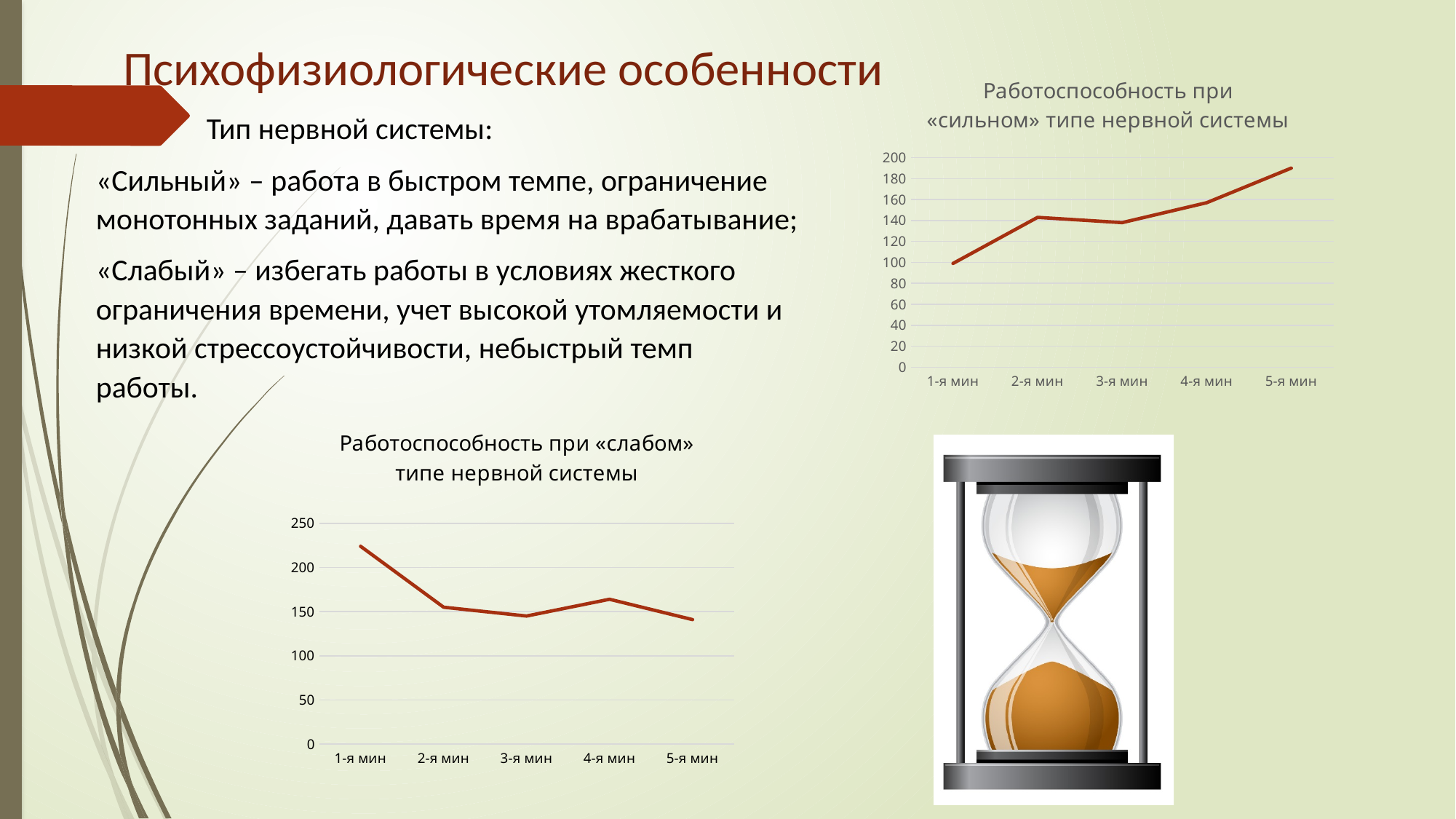
In the chart "Работоспособность при «слабом» типе нервной системы", which minute has the highest value? 1-я мин In the chart "Работоспособность при «слабом» типе нервной системы", is the value for 5-я мин greater or less than 150? less In the chart "Работоспособность при «сильном» типе нервной системы", do the values generally rise or fall from 1-я мин to 5-я мин? rise In the chart "Работоспособность при «слабом» типе нервной системы", is the value for 1-я мин greater or less than 200? greater In the chart "Работоспособность при «слабом» типе нервной системы", how many categories are on the x axis? 5 In the chart "Работоспособность при «слабом» типе нервной системы", which is larger, the value for 1-я мин or the value for 3-я мин? 1-я мин What kind of chart is "Работоспособность при «сильном» типе нервной системы"? line chart In the chart "Работоспособность при «сильном» типе нервной системы", how many points are plotted along the x axis? 5 What kind of chart is "Работоспособность при «слабом» типе нервной системы"? line chart In the chart "Работоспособность при «сильном» типе нервной системы", which minute has the highest value? 5-я мин In the chart "Работоспособность при «сильном» типе нервной системы", which minute has the lowest value? 1-я мин In the chart "Работоспособность при «сильном» типе нервной системы", is the value for 5-я мин greater or less than 180? greater